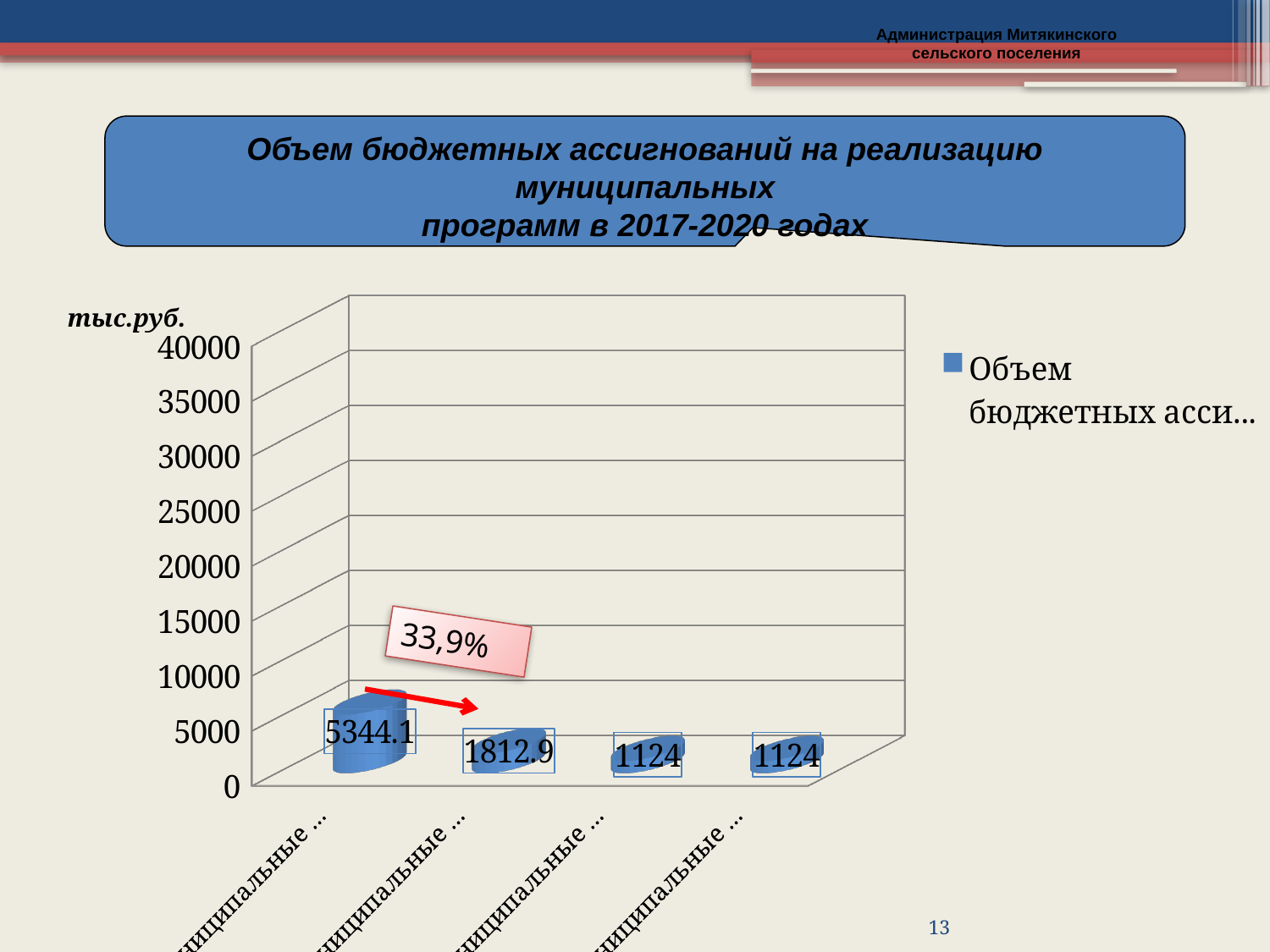
What unit label is shown above the vertical axis? тыс.руб. Do the values rise or fall from left to right along the x axis? fall What kind of chart is shown on the slide? bar chart How many bars are plotted in the chart? 4 What is the difference between the first bar (5344.1) and the second bar (1812.9)? 3531.2 How many series does the legend list? 1 Which is larger, the second bar or the third bar? the second bar What is the value of the first (leftmost) bar? 5344.1 What is the value of the third bar from the left? 1124 Is the value of the first bar greater or less than 10000? less Which bar has the highest value? the first (leftmost) bar What is the value of the second bar from the left? 1812.9